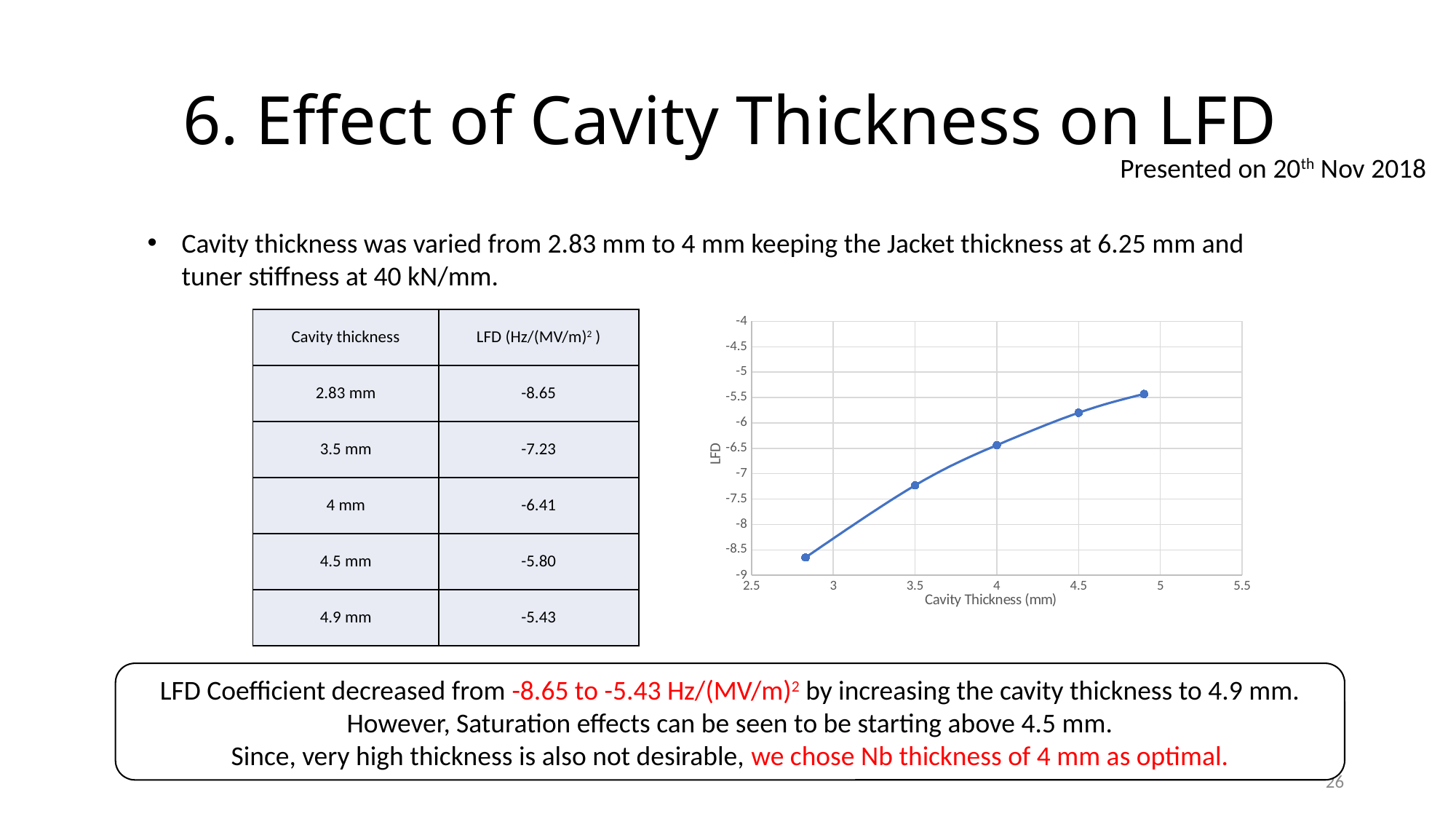
What is the LFD value at a cavity thickness of 2.83 mm? -8.65 What is the LFD value at a cavity thickness of 4 mm? -6.41 Is the LFD value at 4 mm cavity thickness greater or less than -6? less At which cavity thickness is the LFD value highest? 4.9 mm What type of chart is shown on the slide? line chart What is the label of the x axis of the chart? Cavity Thickness (mm) What is the difference between the LFD values at 4.9 mm and 2.83 mm cavity thickness? 3.22 Which has a larger LFD value: 3.5 mm or 4.5 mm cavity thickness? 4.5 mm Do the LFD values rise or fall as cavity thickness increases along the x axis? rise What is the LFD value at a cavity thickness of 4.9 mm? -5.43 How many data points are plotted on the chart? 5 At which cavity thickness is the LFD value lowest? 2.83 mm